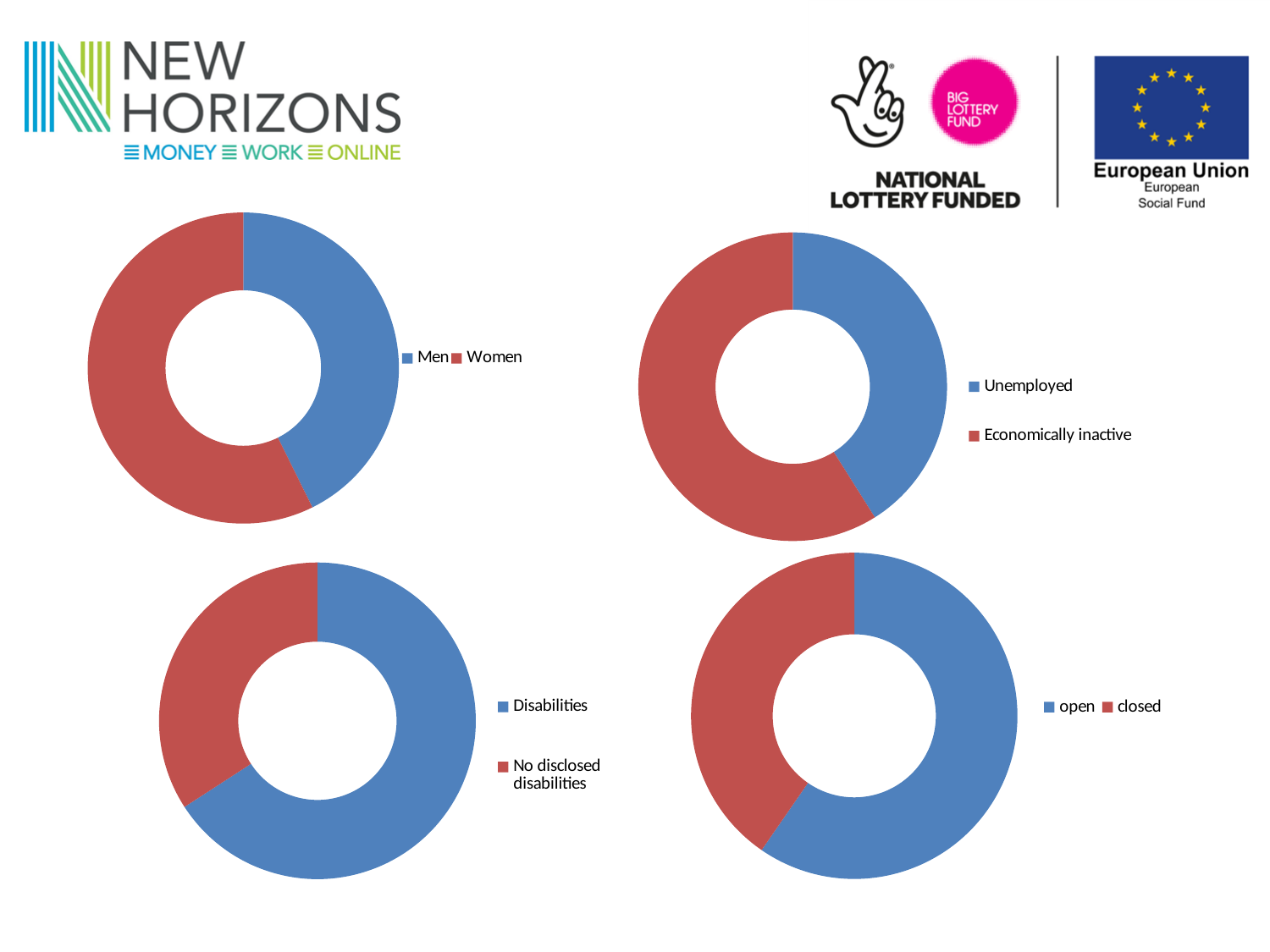
In the bottom-right chart, which category has the larger share: open or closed? open In the bottom-left chart, which category has the larger share: Disabilities or No disclosed disabilities? Disabilities How many categories does the legend of the top-left chart list? 2 In the bottom-left chart, which category has the smaller share? No disclosed disabilities In the top-left chart, which category has the smaller share? Men In the top-right chart, which category has the larger share: Unemployed or Economically inactive? Economically inactive In the top-right chart, which category has the smaller share? Unemployed How many slices does the top-right chart have? 2 In the top-left chart, which category has the larger share: Men or Women? Women What kind of chart is the top-left chart with the Men and Women legend? doughnut chart In the bottom-right chart, what colour is the slice for closed? red How many doughnut charts are shown on the slide? 4